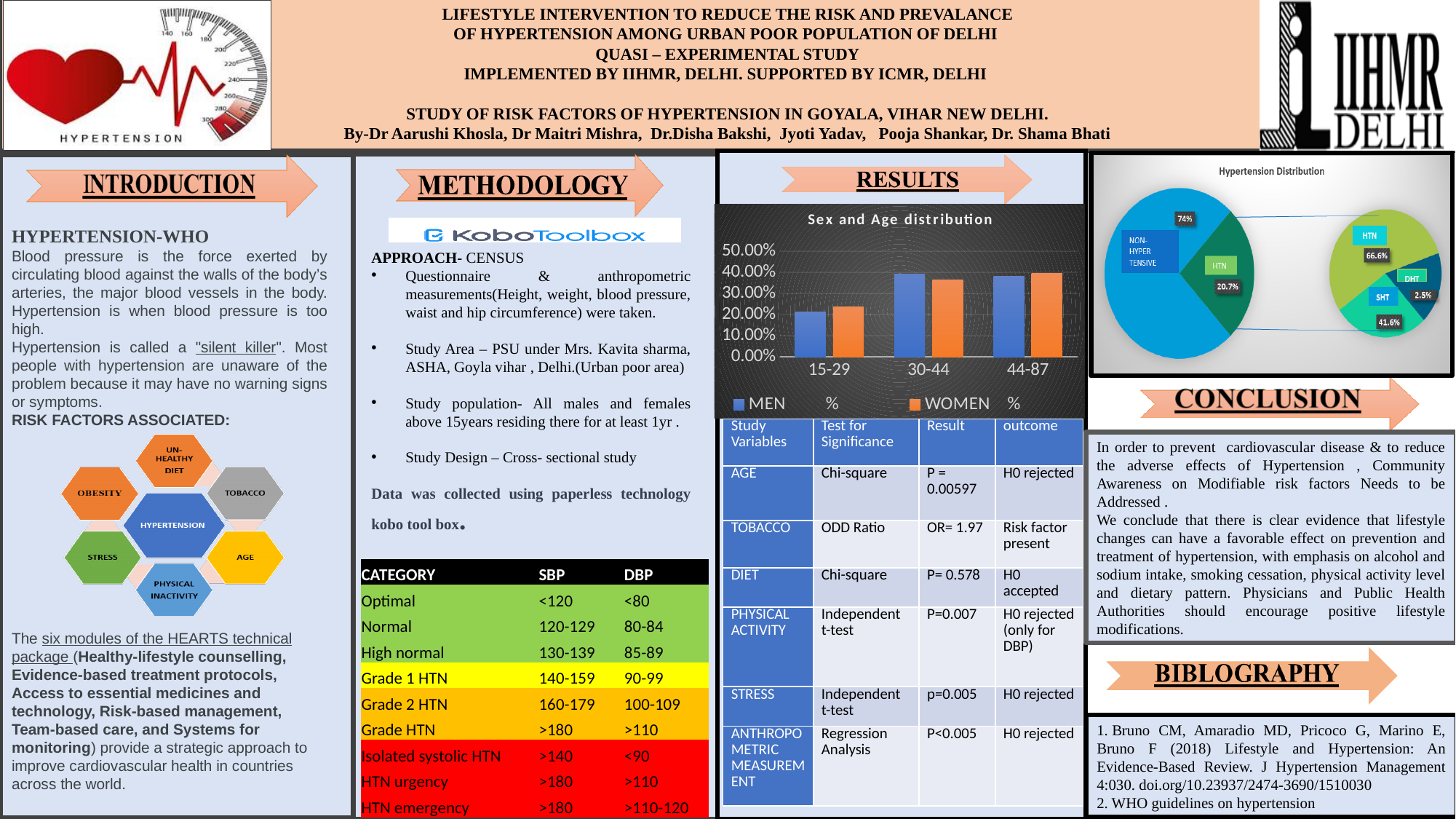
In the 'Sex and Age distribution' chart, is the value for MEN in the 30-44 group greater or less than 30.00%? greater In the 'Sex and Age distribution' chart, does the WOMEN value rise or fall from the 15-29 group to the 30-44 group? rise In the 'Sex and Age distribution' chart, is the value for WOMEN in the 44-87 group greater or less than 50.00%? less What is the title of the bar chart in the RESULTS section? Sex and Age distribution In the 'Sex and Age distribution' chart, which age group has the lowest value for WOMEN? 15-29 What kind of chart is the 'Sex and Age distribution' chart? bar chart In the 'Sex and Age distribution' chart, which age group has the lowest value for MEN? 15-29 In the 'Sex and Age distribution' chart, which is larger: the MEN value for 15-29 or the MEN value for 30-44? 30-44 How many series does the legend of the 'Sex and Age distribution' chart list? 2 In the 'Hypertension Distribution' pie chart, what percentage is labelled on the NON-HYPERTENSIVE slice? 74% How many age categories are shown on the x axis of the 'Sex and Age distribution' chart? 3 In the 'Sex and Age distribution' chart, is the value for MEN in the 15-29 group greater or less than 30.00%? less